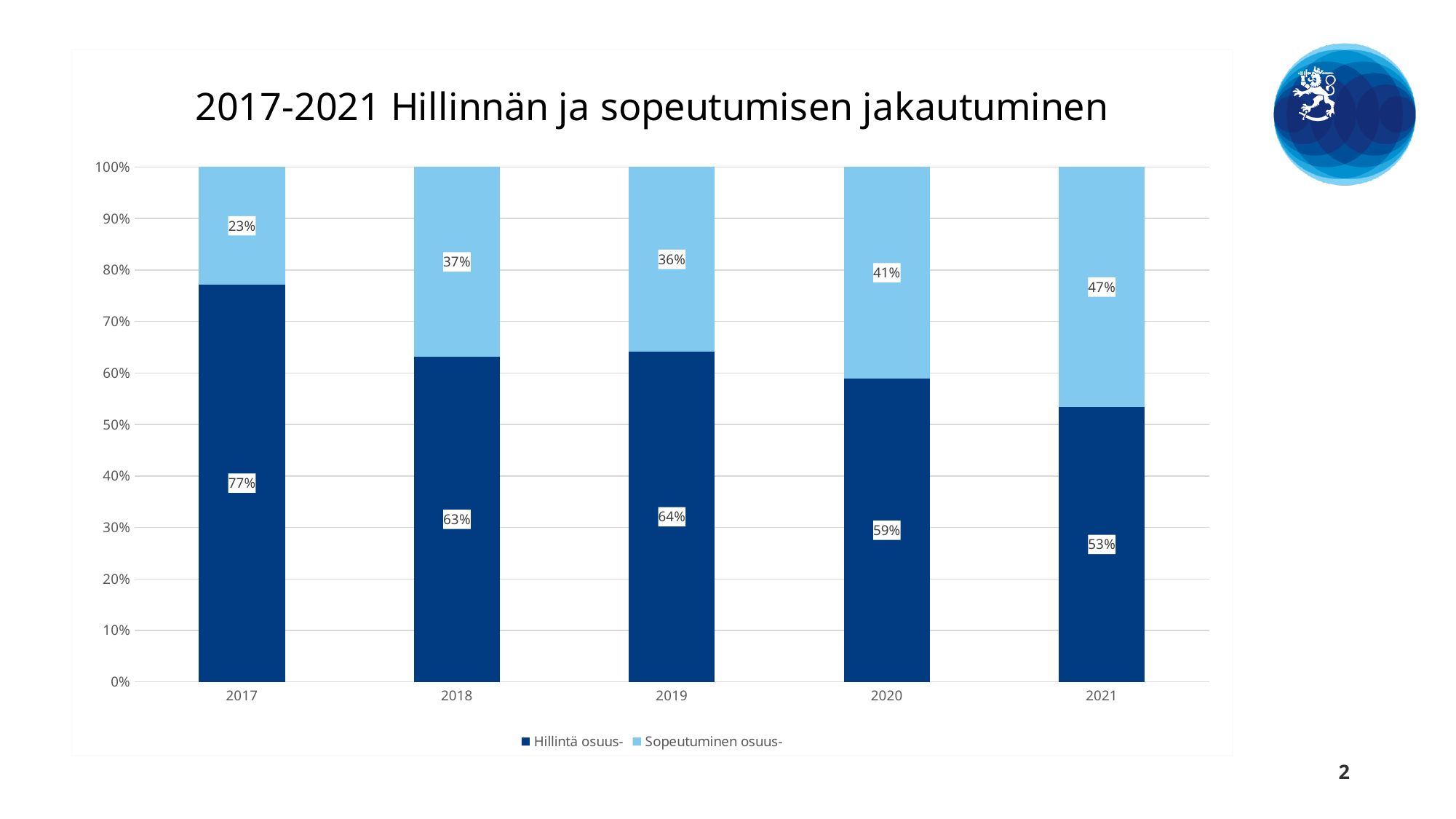
What is the value for Sopeutuminen osuus- in 2021? 47% What is the value for Hillintä osuus- in 2017? 77% Which is larger in 2018: Hillintä osuus- or Sopeutuminen osuus-? Hillintä osuus- In which year is Hillintä osuus- highest? 2017 How many series does the legend list? 2 What is the value for Sopeutuminen osuus- in 2019? 36% In which year is Sopeutuminen osuus- lowest? 2017 What is the difference between Hillintä osuus- and Sopeutuminen osuus- in 2020? 18% Does Sopeutuminen osuus- generally rise or fall from 2017 to 2021? Rise What kind of chart is shown? Stacked bar chart How many years are shown on the x axis? 5 What is the title of the chart? 2017-2021 Hillinnän ja sopeutumisen jakautuminen